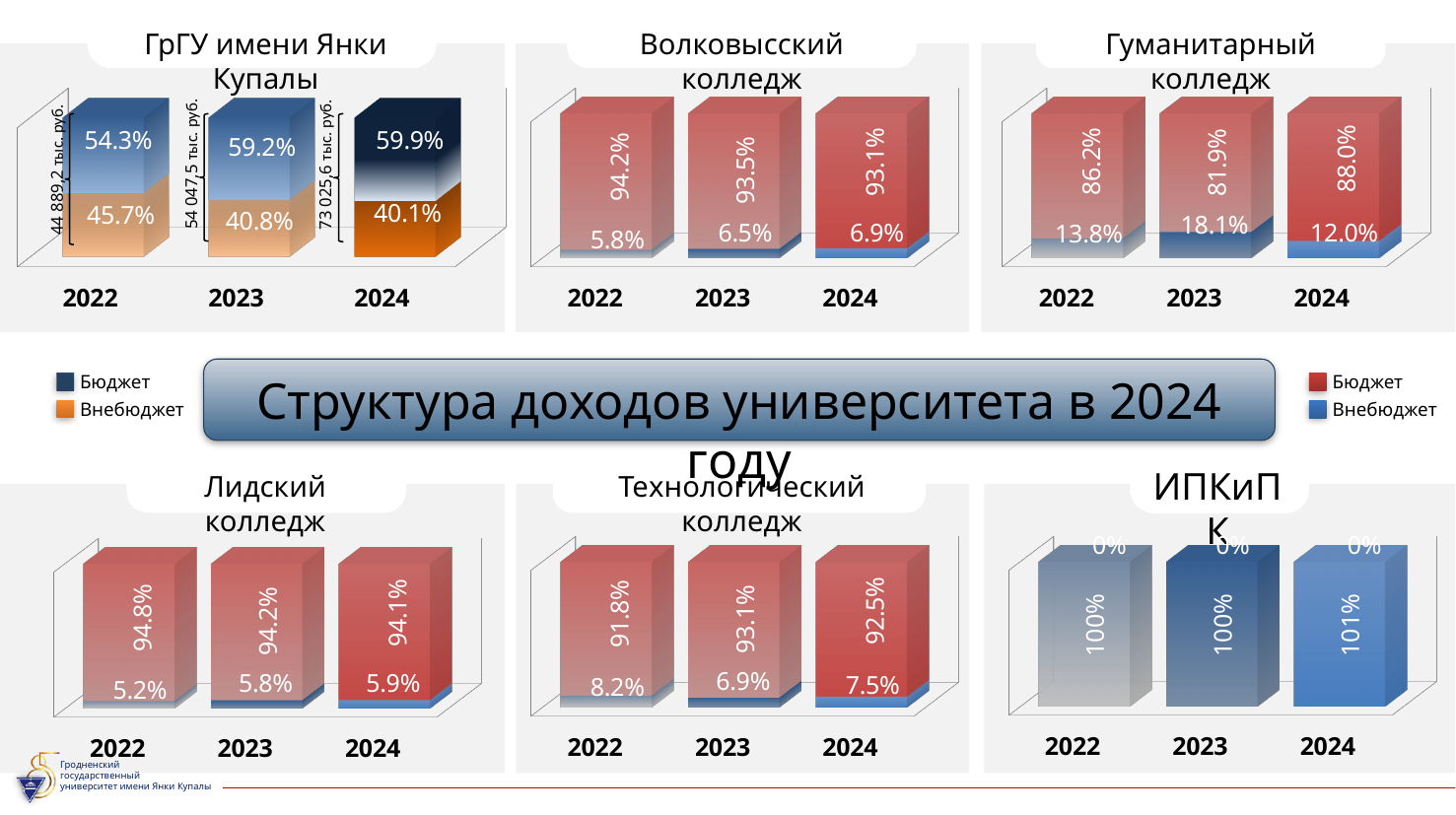
On the Лидский колледж chart, what is the Бюджет share for 2022? 94.8% How many years (categories) does each chart on the slide show? 3 On the Технологический колледж chart, which year has the lowest Бюджет share? 2022 On the Волковысский колледж chart, what is the Внебюджет share for 2023? 6.5% What kind of chart is used for the Волковысский колледж data? Stacked bar chart On the ИПКиПК chart, what value is shown for the Бюджет share in 2024? 0% On the ГрГУ имени Янки Купалы chart, what total amount in тыс. руб. is shown for 2024? 73 025,6 тыс. руб. On the ГрГУ имени Янки Купалы chart, what is the Внебюджет share for 2022? 45.7% On the ГрГУ имени Янки Купалы chart, what is the Бюджет share for 2024? 59.9% On the Гуманитарный колледж chart, which year has the highest Внебюджет share? 2023 On the Технологический колледж chart, is the Внебюджет share larger in 2022 or in 2024? 2022 On the Гуманитарный колледж chart, what is the difference between the Бюджет shares for 2024 and 2023? 6.1%